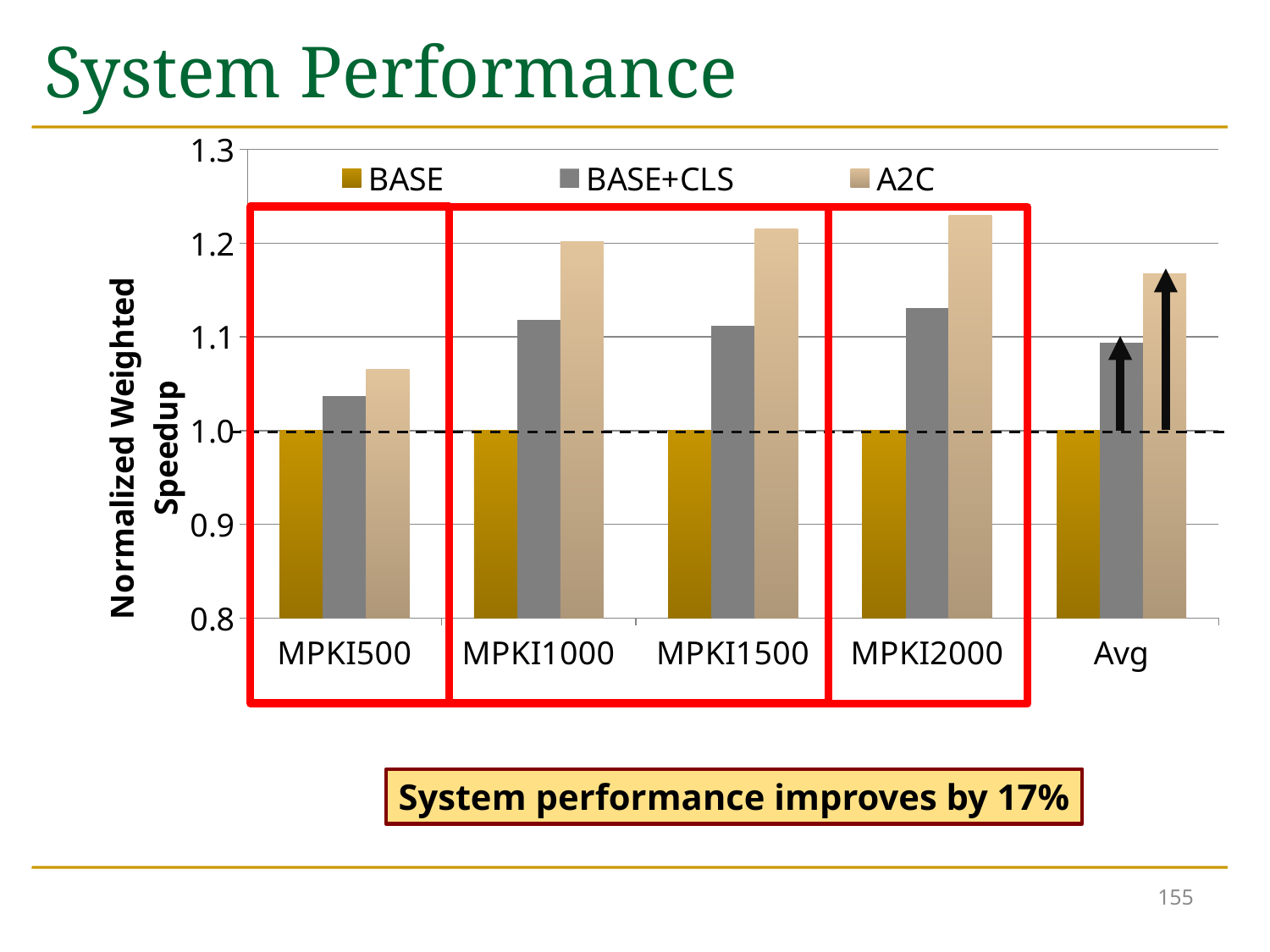
Which category has the lowest A2C value? MPKI500 How many series does the legend list? 3 Is the A2C value for Avg greater or less than 1.2? less What is the Normalized Weighted Speedup of BASE for MPKI500? 1.0 Which category has the highest A2C value? MPKI2000 What kind of chart is shown on the slide? bar chart What is the label of the y axis? Normalized Weighted Speedup Is the A2C value for MPKI500 greater or less than 1.1? less Is the BASE+CLS value for MPKI2000 greater or less than 1.1? greater Do the A2C values rise or fall from MPKI500 to MPKI2000? rise For MPKI1000, which is larger: BASE+CLS or A2C? A2C How many categories are shown on the x axis? 5